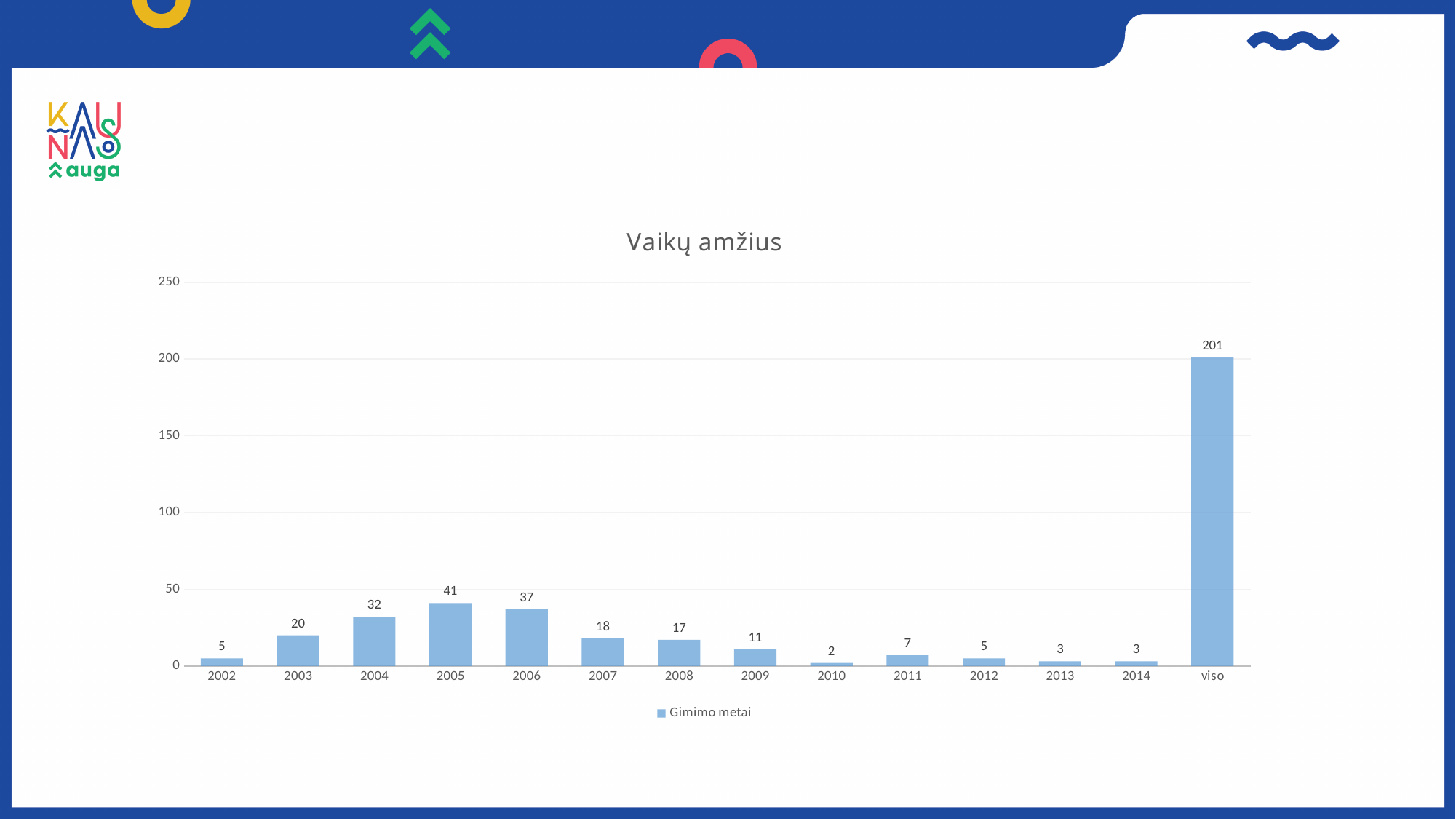
What is the difference between the values for 2005 and 2006? 4 What is the title of the chart? Vaikų amžius Is the value for viso greater or less than 150? greater Which year has the lowest value? 2010 Which is larger, the value for 2004 or the value for 2007? 2004 How many categories are shown on the x axis? 14 What is the value for viso? 201 What is the value for 2010? 2 What is the value for 2005? 41 How many series does the legend list? 1 Which category has the highest value? viso What kind of chart is this? bar chart